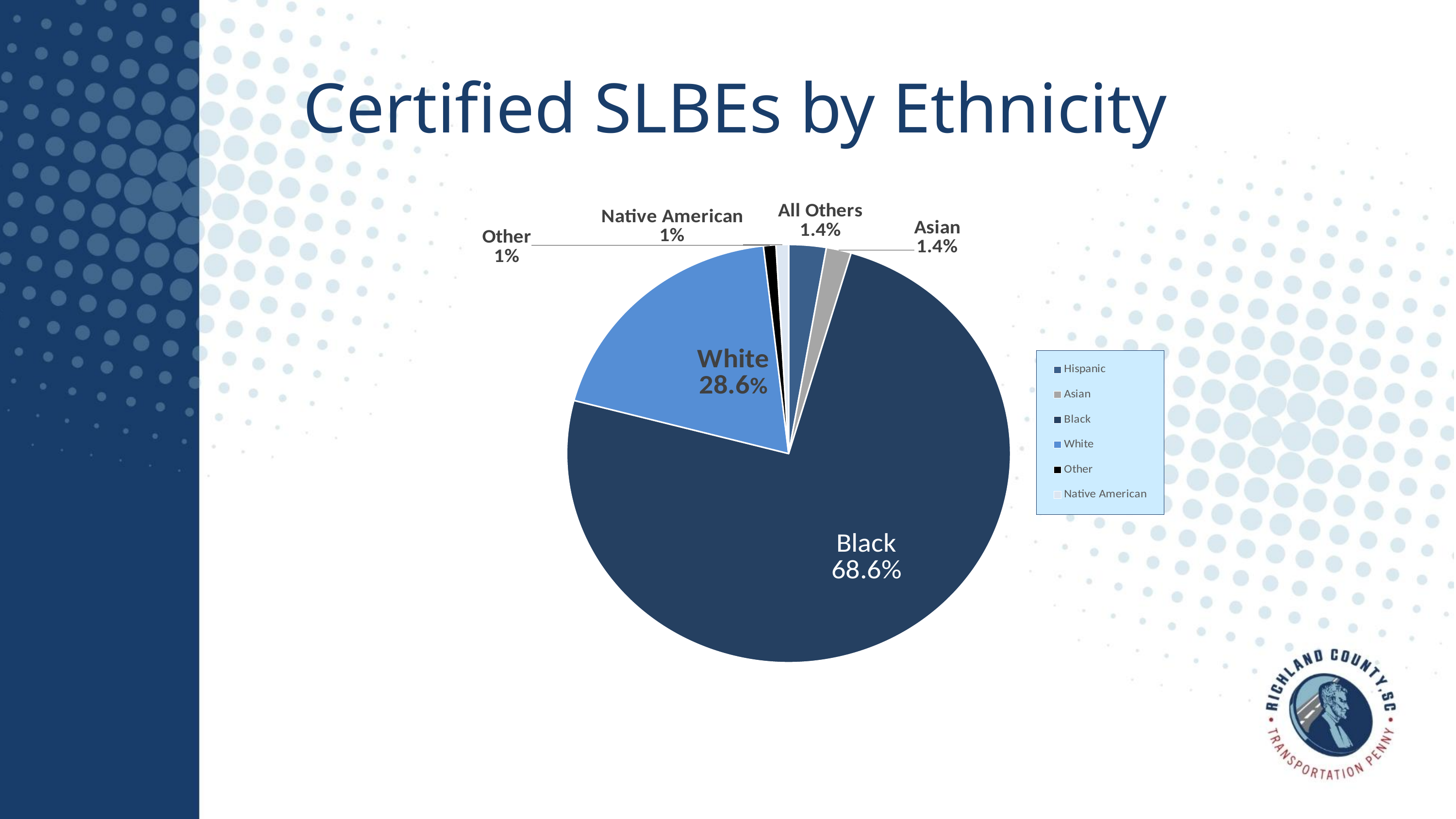
What share of the pie chart is labelled White? 28.6% What percentage is shown for the Asian slice? 1.4% What is the difference in percentage points between the Black and White slices? 40% What is the combined share of the Black and White slices? 97.2% What type of chart is shown on the slide? Pie chart How many slices does the pie chart have? 6 How many entries are listed in the chart legend? 6 Which slice is larger, White or Asian? White What percentage of certified SLBEs are Black according to the pie chart? 68.6% Which ethnicity has the largest share of certified SLBEs? Black What is the title of the slide? Certified SLBEs by Ethnicity What percentage is shown for the Native American slice? 1%